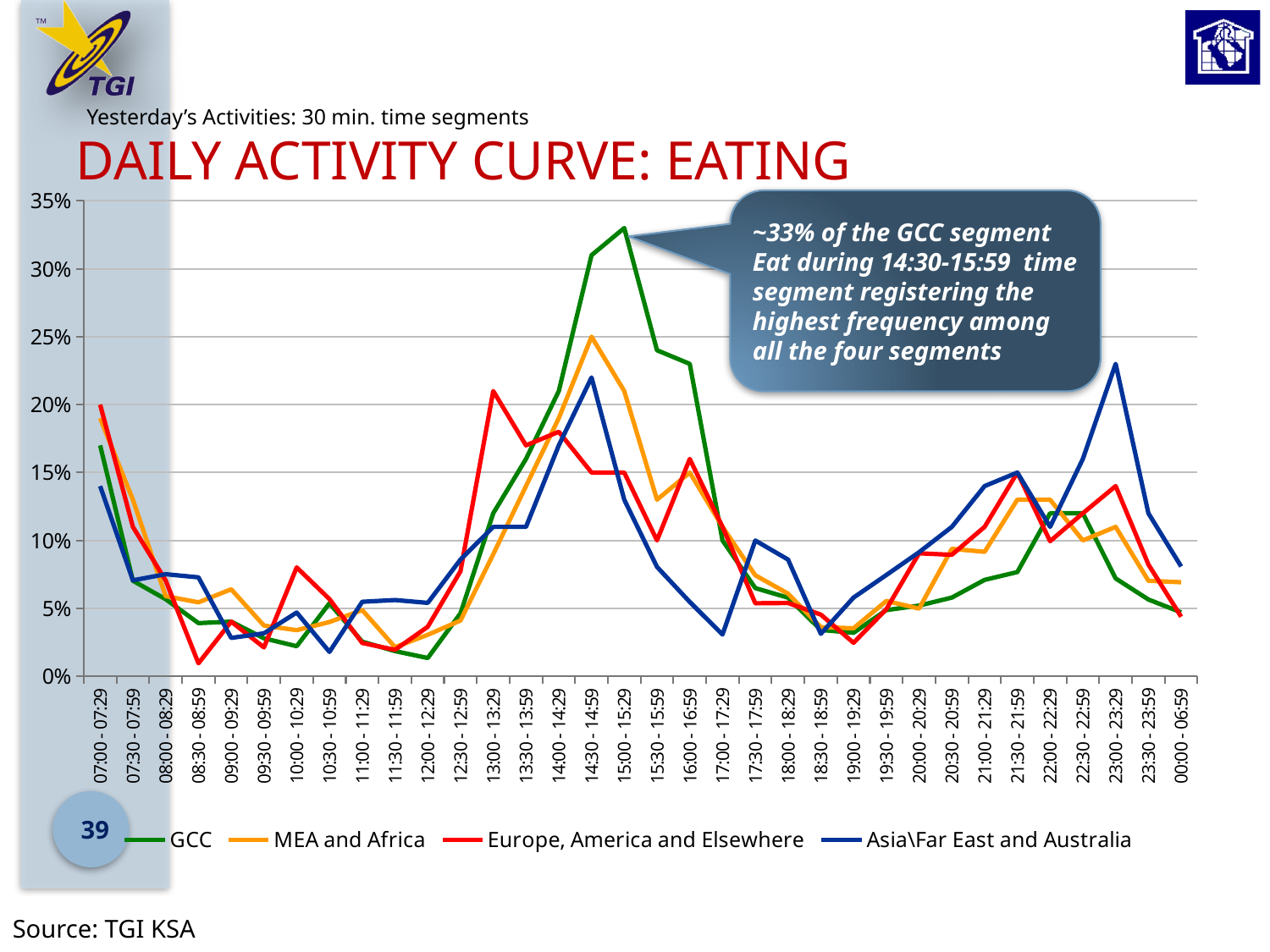
How many time segments are shown on the x axis? 34 Does the GCC line rise or fall from the 07:00 - 07:29 segment to the 08:30 - 08:59 segment? fall What is the title of the chart? DAILY ACTIVITY CURVE: EATING Is the value for GCC in the 15:00 - 15:29 segment greater or less than 30%? greater In the 15:00 - 15:29 segment, which is larger: GCC or Asia\Far East and Australia? GCC What kind of chart is shown on the slide? Line chart Is the value for Asia\Far East and Australia in the 23:00 - 23:29 segment greater or less than 20%? greater Is the value for Europe, America and Elsewhere in the 08:30 - 08:59 segment greater or less than 5%? less Which series reaches the highest value anywhere on the chart? GCC How many series does the legend list? 4 In the 23:00 - 23:29 segment, which is larger: Asia\Far East and Australia or GCC? Asia\Far East and Australia